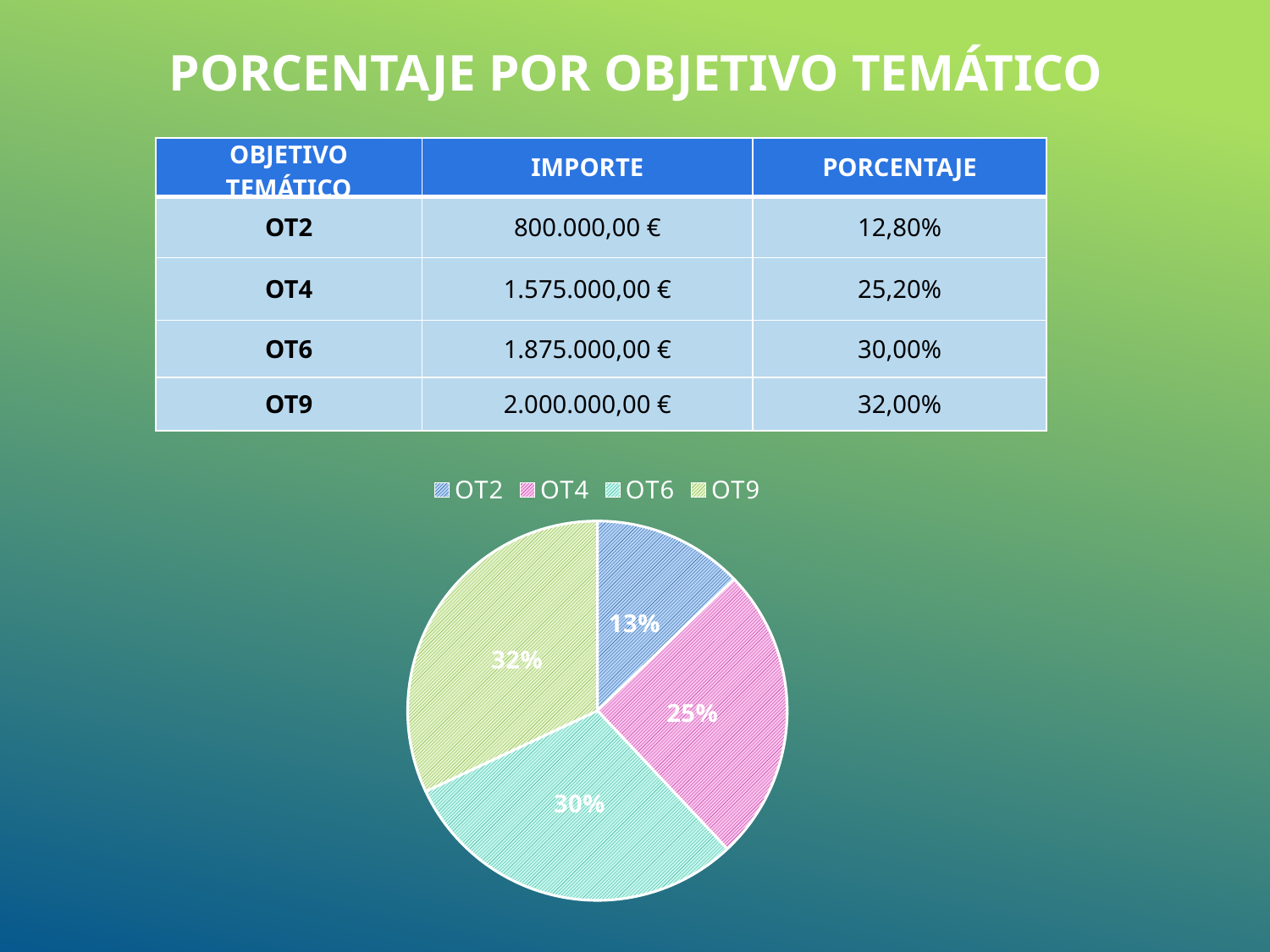
Which category has the largest slice in the pie chart? OT9 What percentage does the pie chart show for OT2? 13% How many entries does the legend of the pie chart list? 4 How many slices does the pie chart have? 4 What is the difference in percentage points between the OT9 slice and the OT2 slice in the pie chart? 19% What type of chart is shown on the slide? pie chart Which legend entry is shown in pink in the pie chart? OT4 What percentage does the pie chart show for OT9? 32% What percentage does the pie chart show for OT4? 25% Which slice is larger in the pie chart, OT4 or OT6? OT6 Which category has the smallest slice in the pie chart? OT2 What percentage does the pie chart show for OT6? 30%